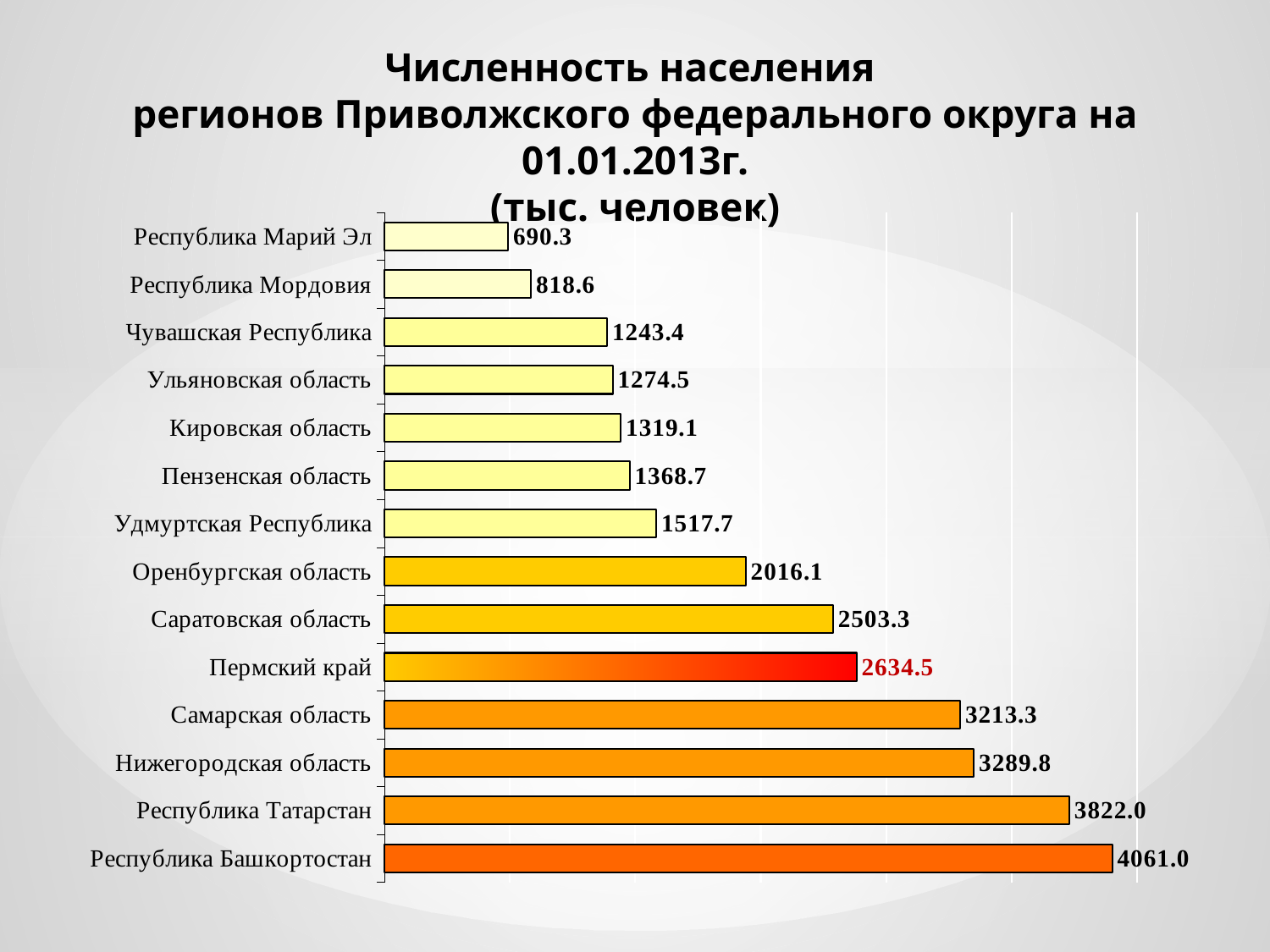
How many regions are shown on the chart? 14 What is the difference between the values for Республика Башкортостан and Республика Татарстан? 239.0 Which has a larger value, Саратовская область or Оренбургская область? Саратовская область What kind of chart is shown on the slide? Bar chart Which bar is highlighted with a red gradient and red data label? Пермский край Which region has the highest population on the chart? Республика Башкортостан What is the population value shown for Пермский край? 2634.5 What is the population value shown for Республика Татарстан? 3822.0 What is the population value shown for Республика Марий Эл? 690.3 Which has a larger value, Нижегородская область or Самарская область? Нижегородская область What is the difference between the values for Самарская область and Пермский край? 578.8 Which region has the lowest population on the chart? Республика Марий Эл